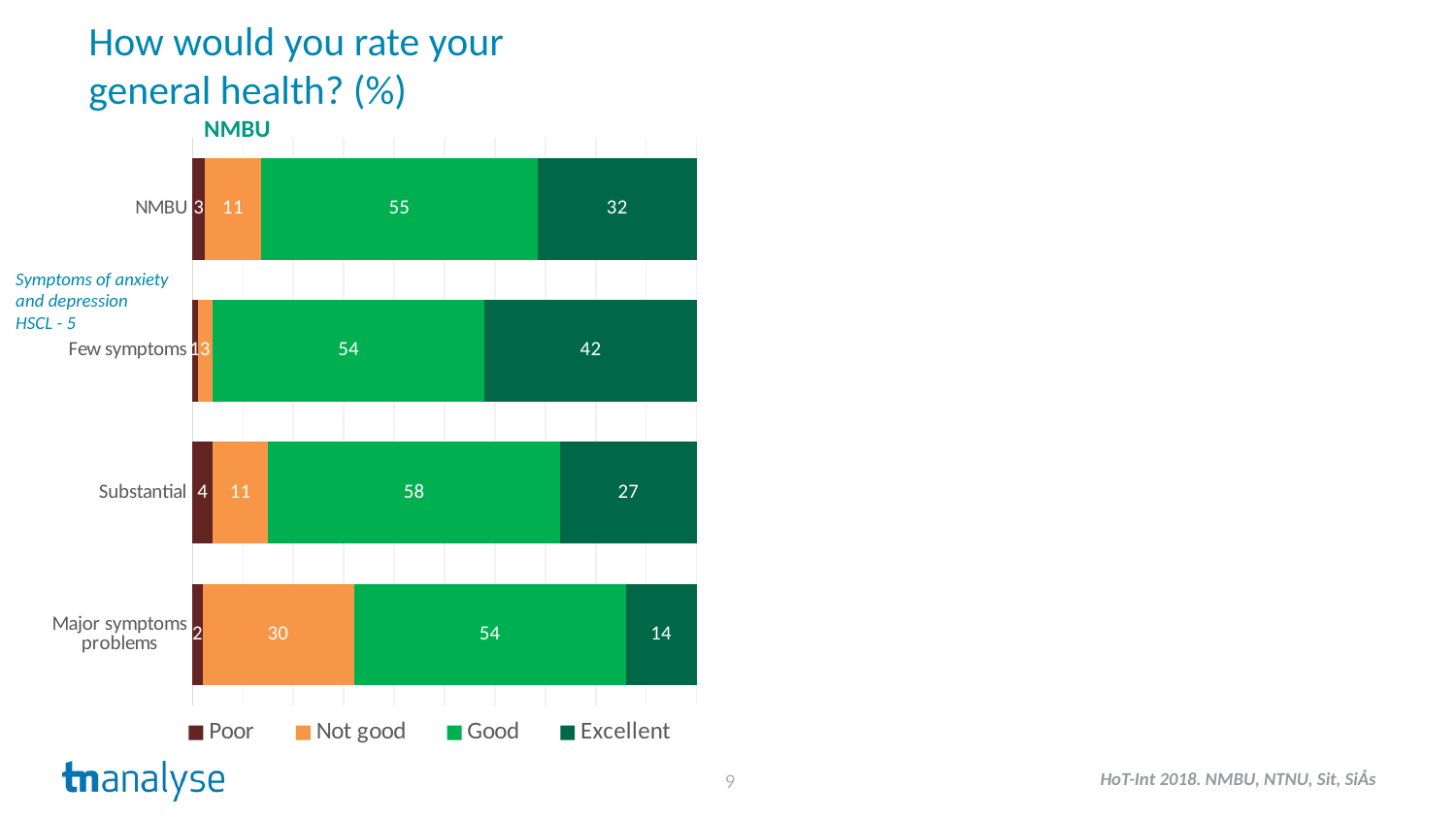
Which series is shown in orange in the legend? Not good How many categories (bars) are plotted in the chart? 4 Which is larger: the 'Not good' value for Major symptoms problems or for Substantial? Major symptoms problems What is the 'Good' value for the Substantial category? 58 Which category has the lowest 'Excellent' value? Major symptoms problems What is the 'Excellent' value for the Few symptoms category? 42 What is the difference between the 'Excellent' values for NMBU and Major symptoms problems? 18 Which category has the highest 'Excellent' value? Few symptoms What kind of chart is shown on the slide? stacked bar chart What is the 'Not good' value for the Major symptoms problems category? 30 How many series does the legend list? 4 What is the total of the stacked bar for Substantial? 100